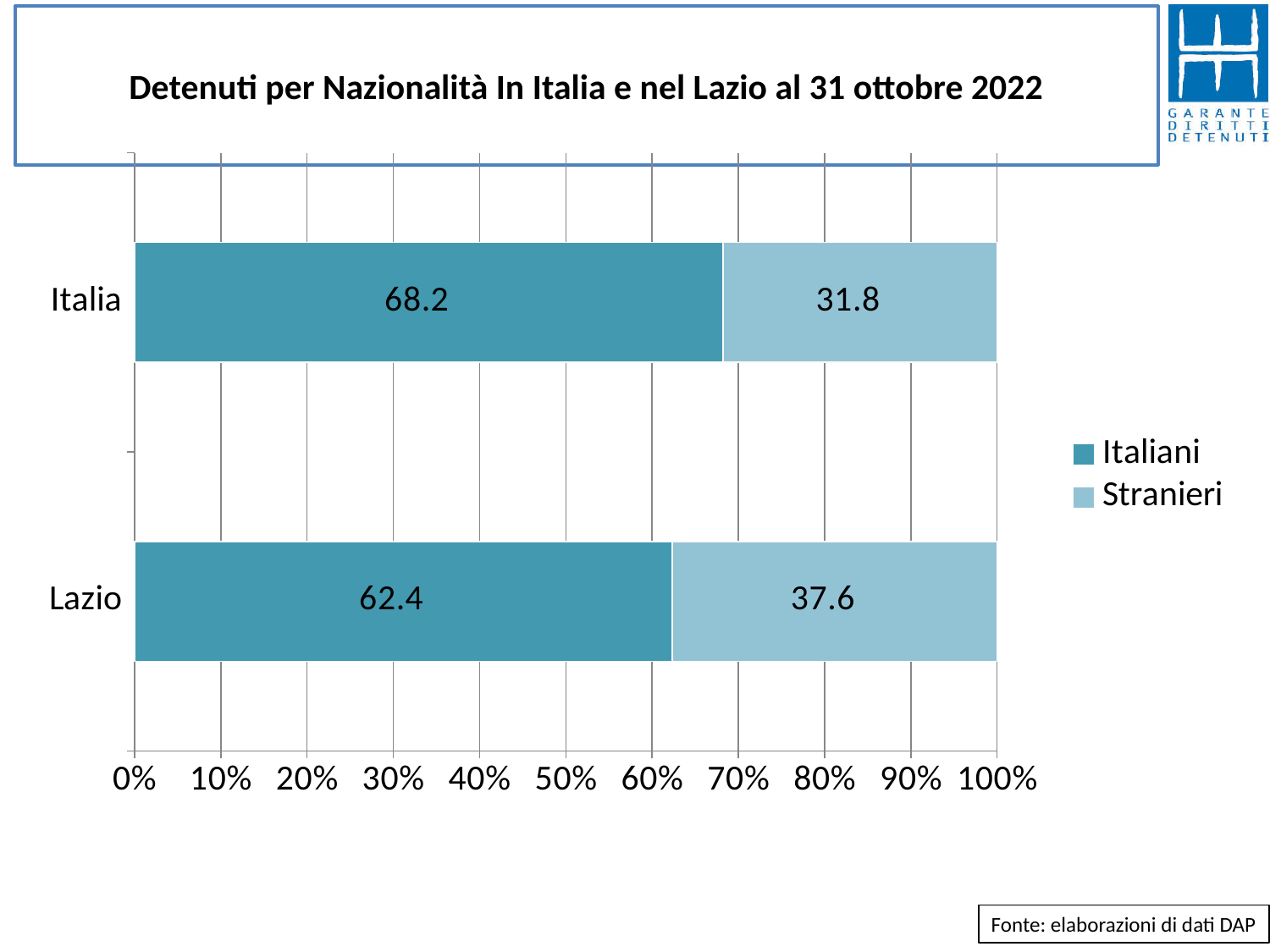
What is the value for Stranieri in Lazio? 37.6 What is the value for Italiani in Lazio? 62.4 How many series does the legend list? 2 How many categories are shown on the chart? 2 What is the total of the stacked bar for Italia? 100 Which category has the lower Stranieri value? Italia Which category has the higher Italiani value, Italia or Lazio? Italia What is the value for Italiani in Italia? 68.2 What is the difference between the Italiani values for Italia and Lazio? 5.8 What is the difference between the Italiani and Stranieri values for Lazio? 24.8 What is the value for Stranieri in Italia? 31.8 What kind of chart is shown on the slide? Stacked bar chart